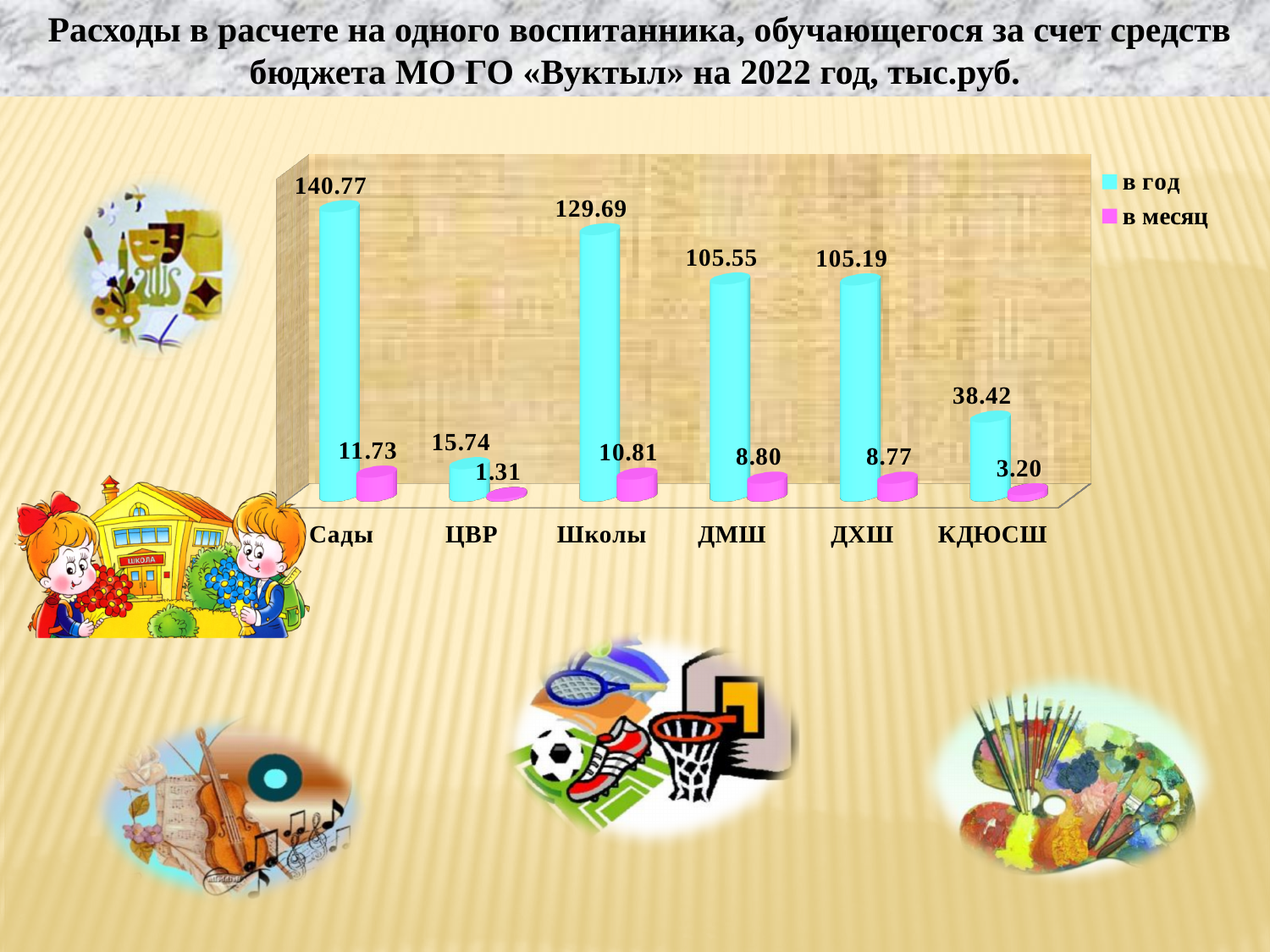
What is the difference between the 'в месяц' values for Школы and КДЮСШ? 7.61 Which category has the lowest 'в месяц' value? ЦВР What is the difference between the 'в год' values for Сады and Школы? 11.08 How many categories are shown on the x axis? 6 What are the two series named in the legend? в год, в месяц What is the value for ЦВР in the 'в месяц' series? 1.31 What is the value for Сады in the 'в год' series? 140.77 What kind of chart is shown on the slide? Bar chart Which is larger, the 'в год' value for Школы or for ДМШ? Школы Which category has the highest 'в год' value? Сады What is the 'в год' value for КДЮСШ? 38.42 How many series does the legend list? 2